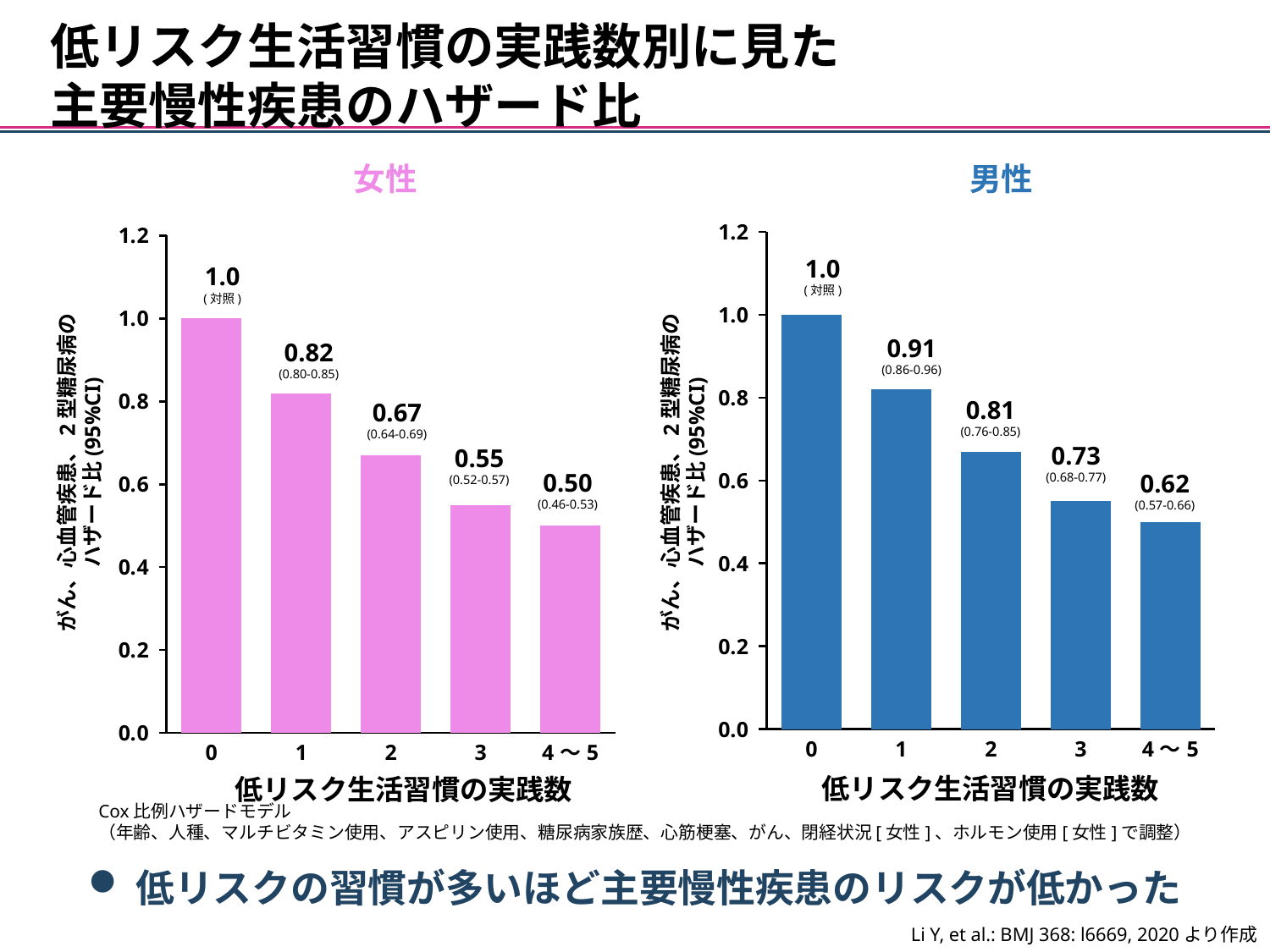
What type of chart is the 男性 chart? Bar chart In the 男性 chart, what is the hazard ratio for 3 low-risk lifestyle practices? 0.73 In the 女性 chart, what is the hazard ratio for 2 low-risk lifestyle practices? 0.67 In the 女性 chart, what is the hazard ratio for the 4～5 category? 0.50 In the 女性 chart, do the hazard ratios rise or fall as the number of low-risk lifestyle practices increases? Fall In the 男性 chart, what is the difference between the hazard ratios for 2 and 4～5 practices? 0.19 In the 女性 chart, which category has the highest hazard ratio? 0 How many categories are shown on the x axis of the 女性 chart? 5 In the 男性 chart, which category has the lowest hazard ratio? 4～5 In the 女性 chart, what is the difference between the hazard ratios for 1 and 3 practices? 0.27 Which is larger: the hazard ratio for 2 practices in the 女性 chart or in the 男性 chart? 男性 In the 男性 chart, what is the hazard ratio for 1 low-risk lifestyle practice? 0.91